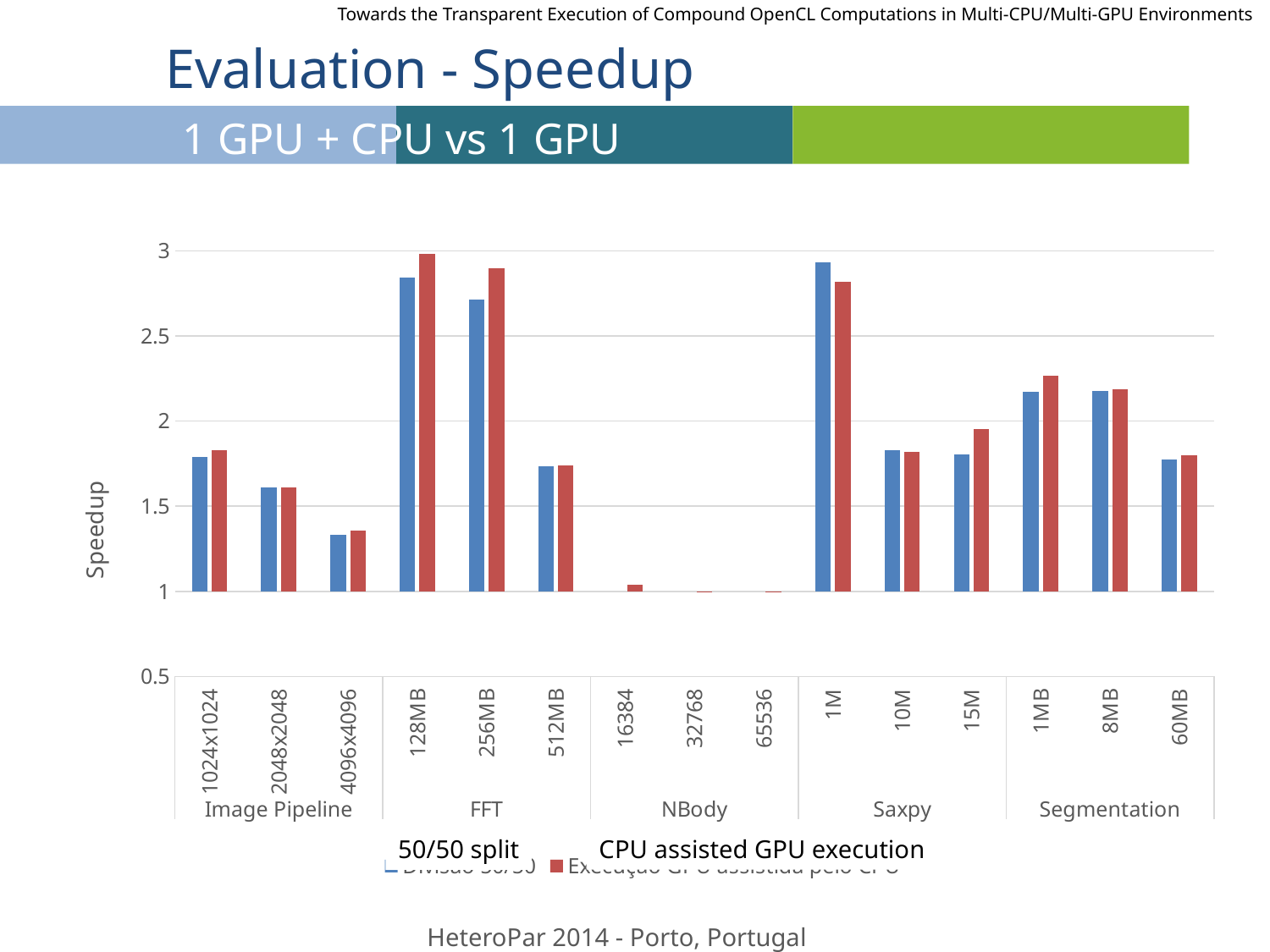
What kind of chart is shown on the slide? bar chart How many series does the legend list? 2 Is the 50/50 split speedup for FFT 128MB greater or less than 2.5? greater Within Image Pipeline, does the 50/50 split speedup rise or fall as the image size increases from 1024x1024 to 4096x4096? fall For Saxpy 1M, which series has the larger speedup? 50/50 split For FFT 128MB, which series has the larger speedup? CPU assisted GPU execution Which benchmark group shows the lowest speedups overall? NBody How many benchmark groups are shown along the x axis? 5 How many input-size categories are plotted in total along the x axis? 15 Is the CPU assisted GPU execution speedup for Image Pipeline 4096x4096 greater or less than 1.5? less Is the 50/50 split speedup for Segmentation 1MB greater or less than 2? greater Which category has the highest CPU assisted GPU execution speedup? FFT 128MB